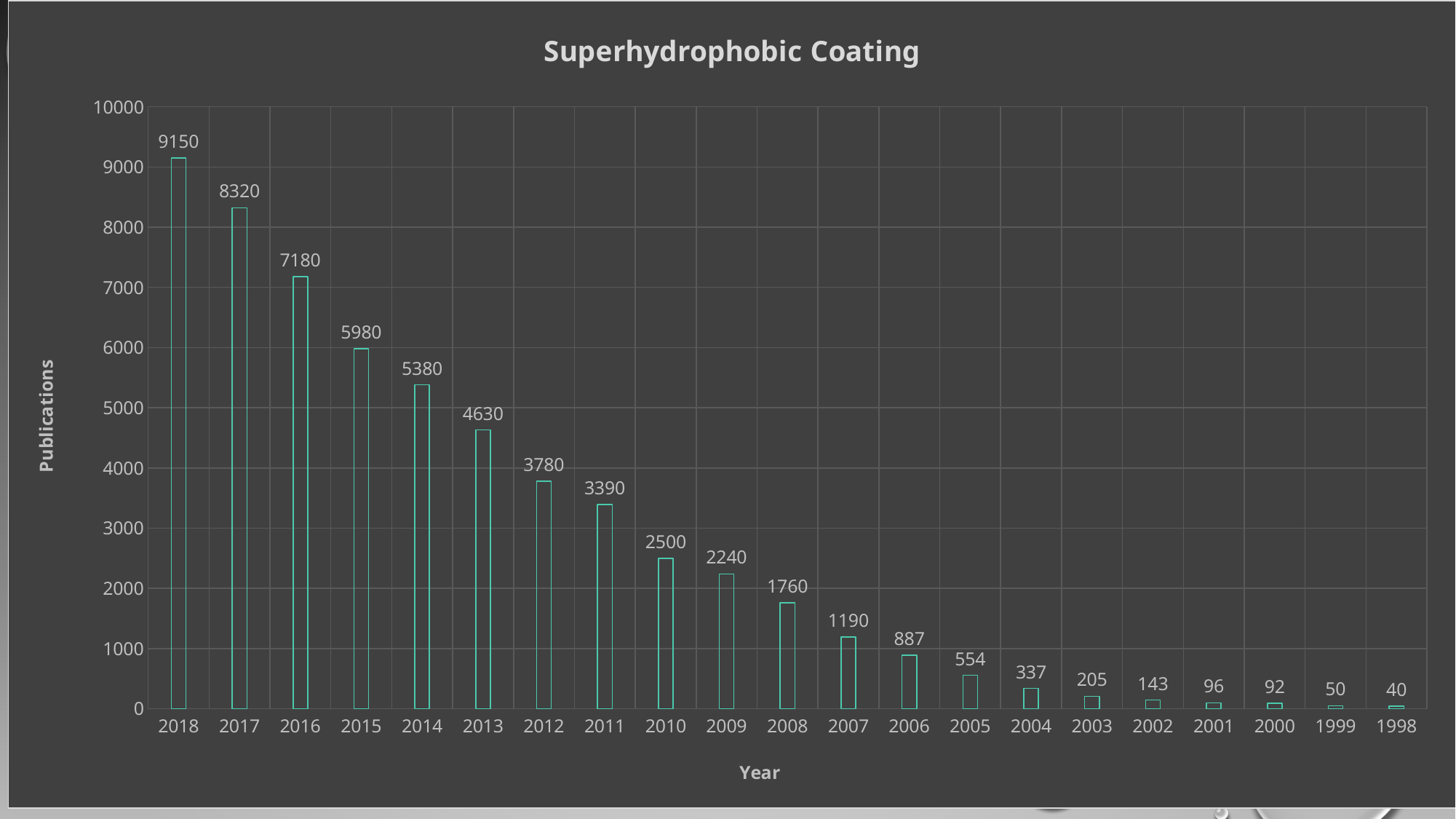
How many years are shown on the x axis? 21 What is the number of publications for 2010? 2500 What kind of chart is shown on the slide? Bar chart Which year has the lowest number of publications? 1998 What is the title of the chart? Superhydrophobic Coating Which year has the highest number of publications? 2018 What is the difference in publications between 2012 and 2011? 390 What is the number of publications for 1998? 40 What is the difference in publications between 2018 and 2017? 830 What is the number of publications for 2018? 9150 Which year has more publications, 2009 or 2008? 2009 Is the value for 2013 greater or less than 4000? greater